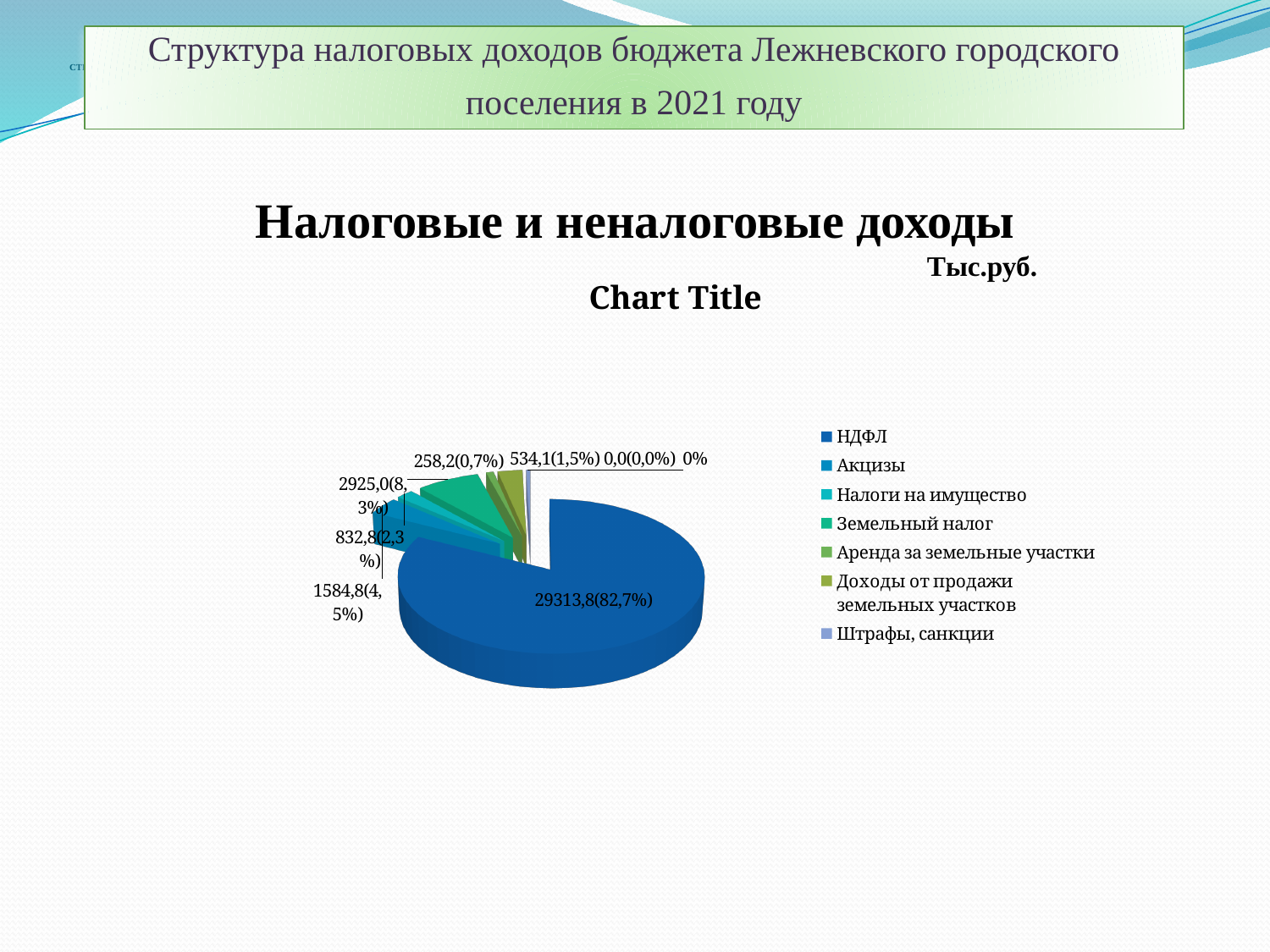
What value is printed for Акцизы in the pie chart? 1584,8(4,5%) What unit is indicated for the values in the chart? Тыс.руб. Which is larger in the pie chart: Земельный налог or Акцизы? Земельный налог How many entries does the legend of the pie chart list? 7 What type of chart is shown on the slide? pie chart What value is printed on the НДФЛ slice of the pie chart? 29313,8(82,7%) What value is printed for Земельный налог in the pie chart? 2925,0(8,3%) Which is larger in the pie chart: НДФЛ or Земельный налог? НДФЛ What is the title shown above the pie chart? Chart Title What share of the pie does НДФЛ account for? 82,7% What is the difference between the НДФЛ value and the Земельный налог value? 26388,8 Which category has the largest slice in the pie chart? НДФЛ